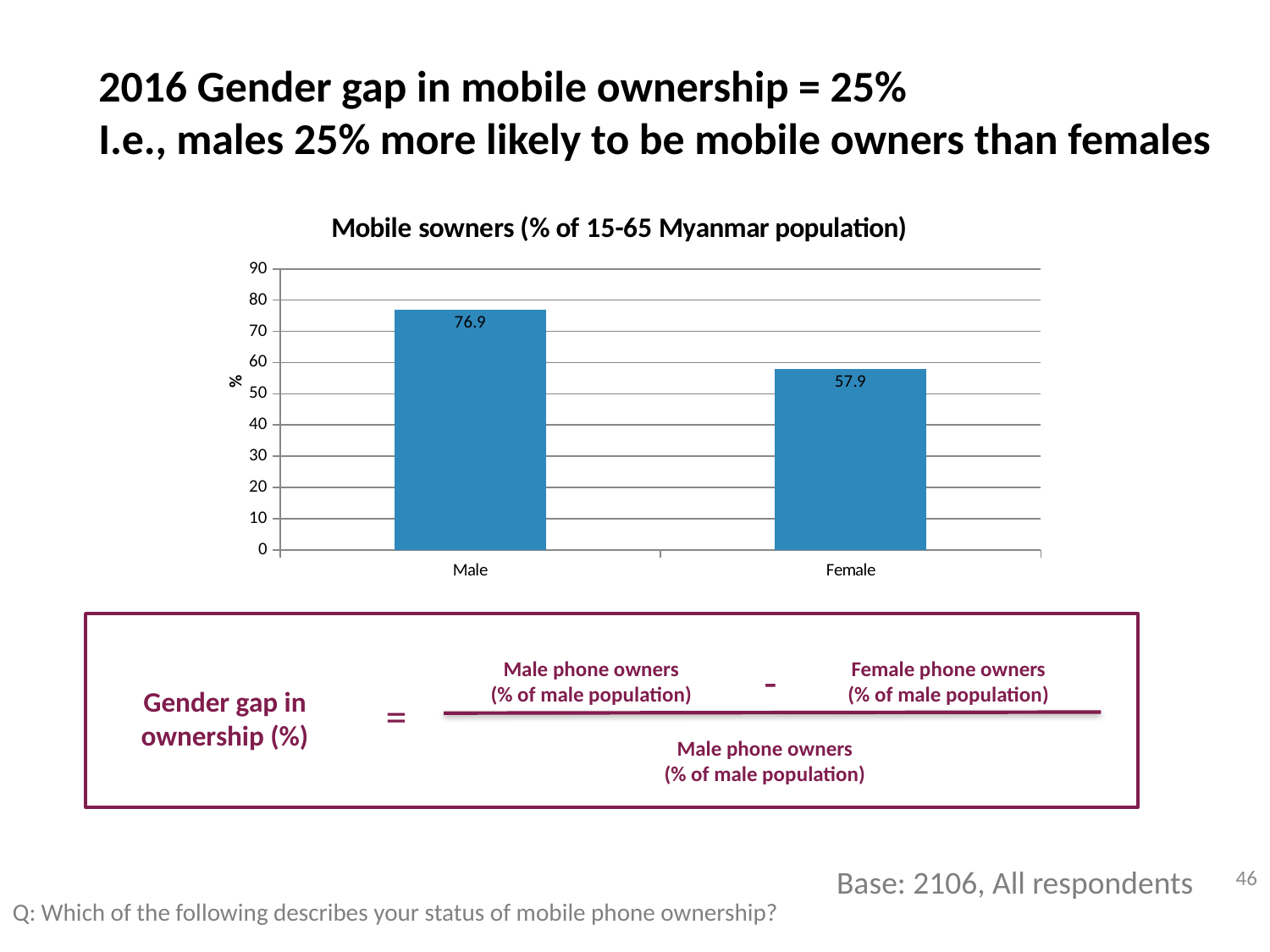
How many categories are shown on the x axis? 2 What is the value for Female in the chart? 57.9 Is the value for Male greater or less than 70? greater What is the value for Male in the chart? 76.9 Which is larger, the value for Male or the value for Female? Male Which category has the highest value? Male What is the label on the y axis of the chart? % Is the value for Female greater or less than 60? less What kind of chart is shown on the slide? bar chart What is the title of the chart? Mobile sowners (% of 15-65 Myanmar population) Which category has the lowest value? Female What is the difference between the Male and Female values? 19